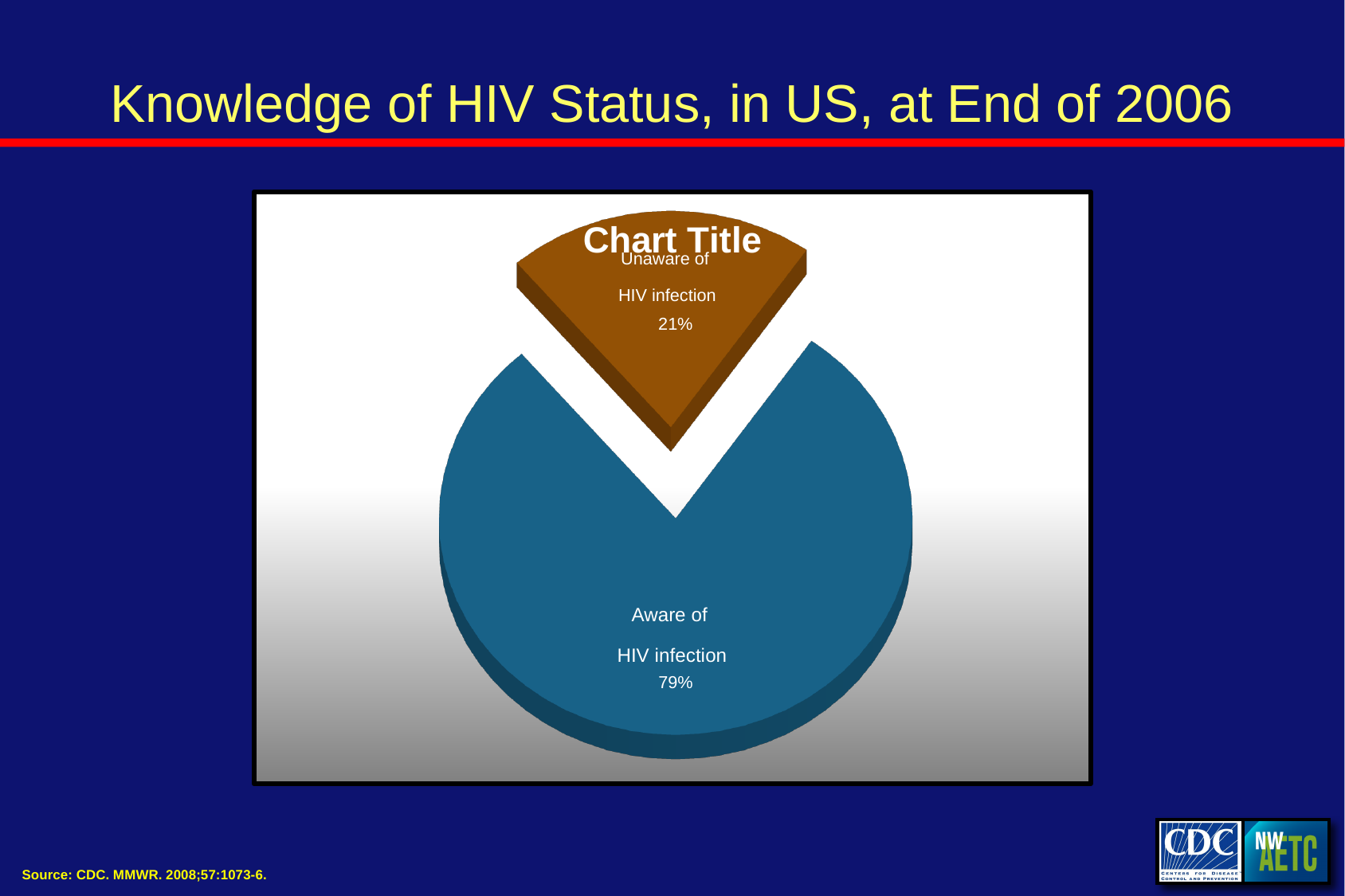
Which slice of the pie is the smallest? Unaware of HIV infection What kind of chart is shown on the slide? pie chart Which slice of the pie is the largest? Aware of HIV infection What is the title of the slide containing the pie chart? Knowledge of HIV Status, in US, at End of 2006 Is the value for 'Aware of HIV infection' greater or less than 50%? greater What colour is the 'Unaware of HIV infection' slice? brown What percentage of the pie is labelled 'Aware of HIV infection'? 79% Which is larger: the 'Aware of HIV infection' slice or the 'Unaware of HIV infection' slice? Aware of HIV infection What is the difference in percentage points between the 'Aware of HIV infection' slice and the 'Unaware of HIV infection' slice? 58 What percentage of the pie is labelled 'Unaware of HIV infection'? 21% How many slices does the pie chart have? 2 What share of the pie does the 'Unaware of HIV infection' slice represent? 21%